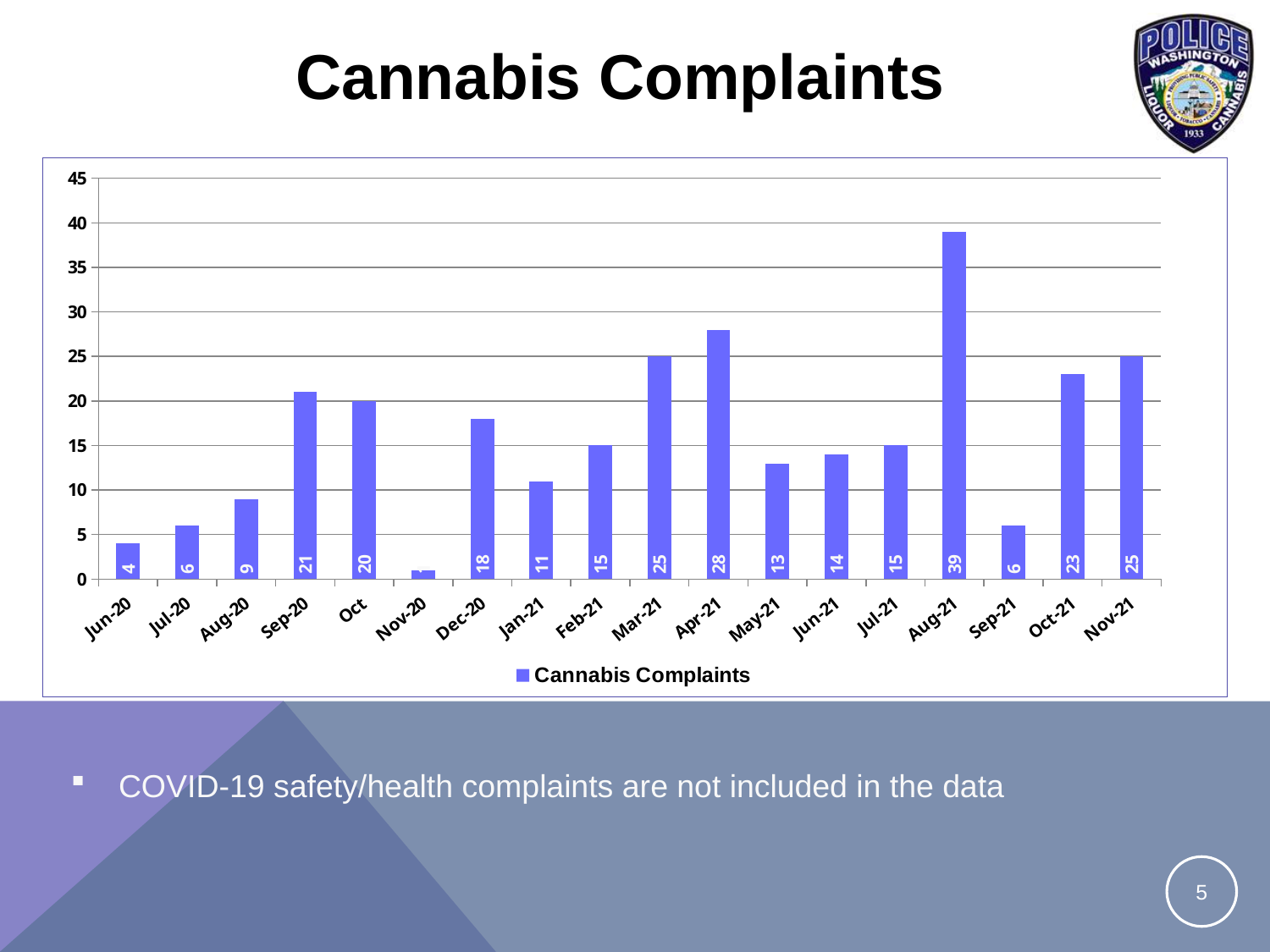
How many months are shown on the x axis of the chart? 18 How many cannabis complaints were recorded in Aug-21? 39 How many cannabis complaints were recorded in Apr-21? 28 How many series does the legend list? 1 Which month has the lowest number of cannabis complaints? Nov-20 Is the value for Dec-20 greater or less than 15? greater How many cannabis complaints were recorded in Sep-20? 21 What is the difference in cannabis complaints between Aug-21 and Sep-21? 33 Which month had more cannabis complaints, Mar-21 or Oct-21? Mar-21 What type of chart is shown on the slide? bar chart What is the name of the series shown in the legend? Cannabis Complaints Which month has the highest number of cannabis complaints? Aug-21